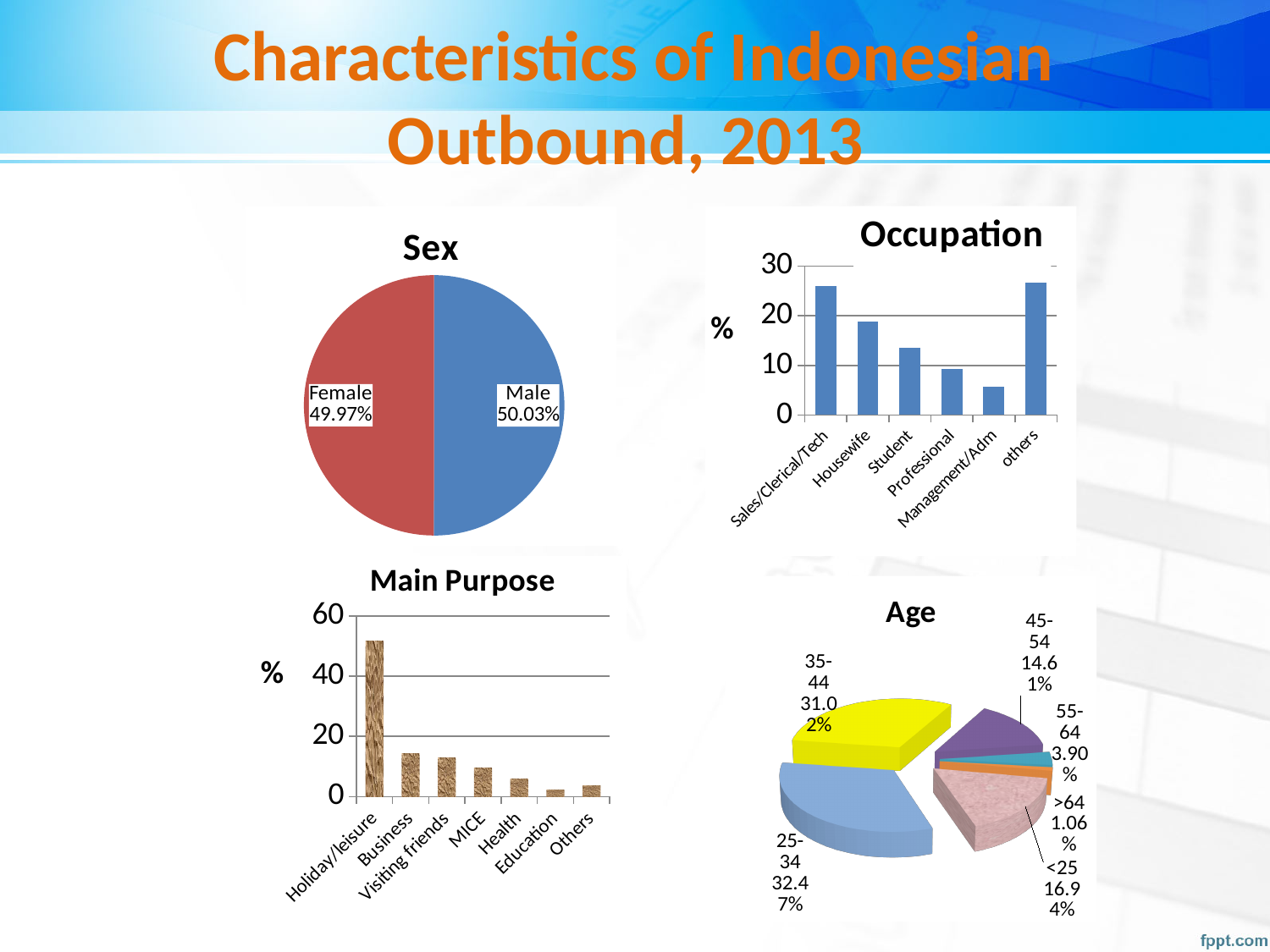
What kind of chart is the Occupation chart? bar chart In the Age chart, what is the difference between the 35-44 share and the 45-54 share? 16.41% In the Occupation chart, which occupation has the lowest value? Management/Adm How many categories are shown in the Main Purpose chart? 7 In the Sex chart, what percentage is Female? 49.97% In the Main Purpose chart, which purpose has the highest value? Holiday/leisure In the Age chart, which age group has the smallest share? >64 In the Age chart, what share is the 25-34 age group? 32.47% In the Occupation chart, is the value for Housewife greater or less than 10? greater In the Main Purpose chart, is the value for Holiday/leisure greater or less than 40? greater How many occupation categories are shown in the Occupation chart? 6 In the Sex chart, what percentage is Male? 50.03%